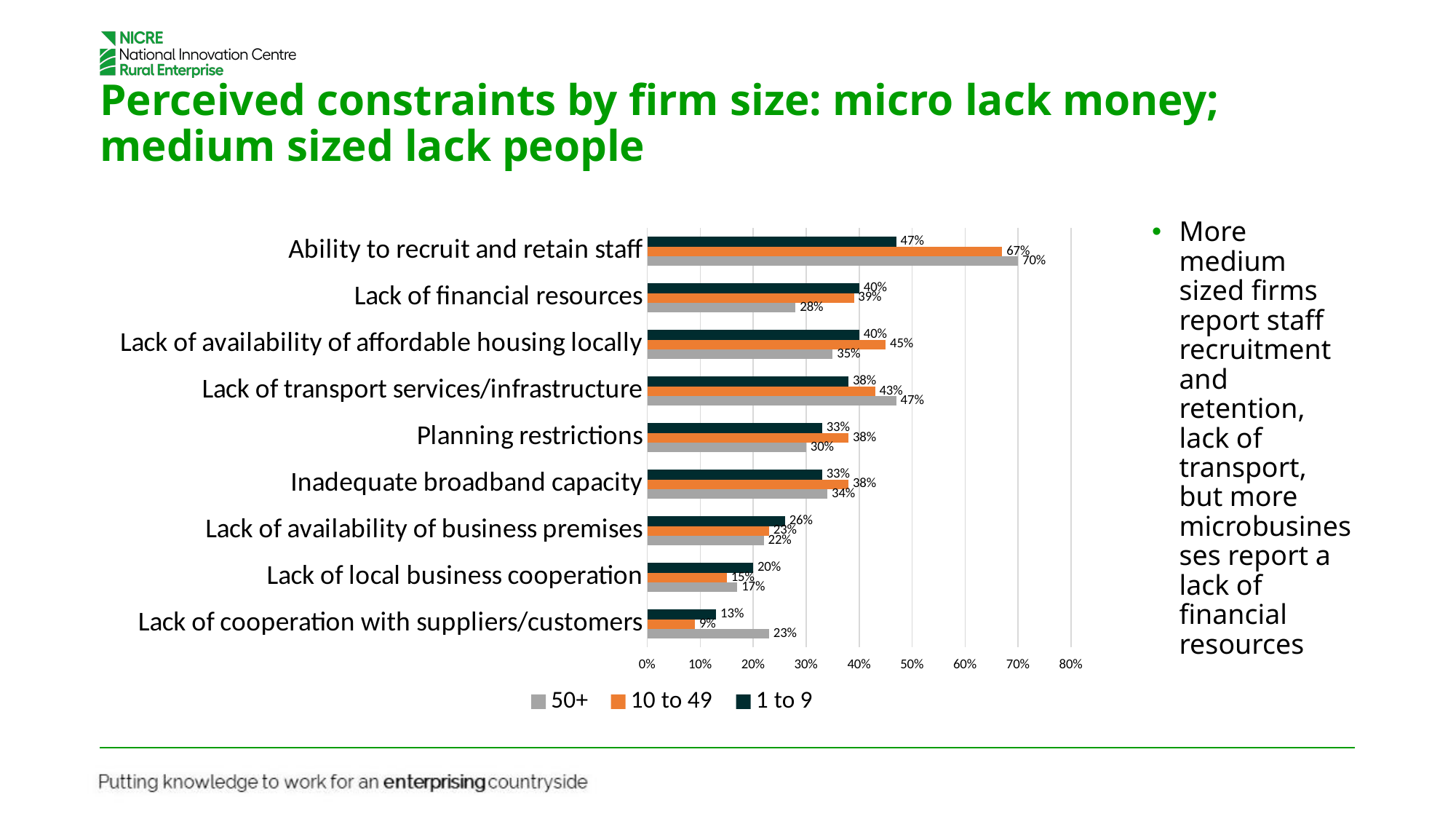
Which constraint has the lowest value for the 1 to 9 series? Lack of cooperation with suppliers/customers What is the difference between the 50+ and 1 to 9 values for 'Ability to recruit and retain staff'? 23 percentage points How many constraint categories are shown on the chart? 9 Is the 50+ value for 'Lack of transport services/infrastructure' greater or less than 40%? greater How many series does the legend list? 3 What is the value for 'Lack of cooperation with suppliers/customers' for the 10 to 49 series? 9% What is the value for 'Lack of financial resources' for the 1 to 9 series? 40% Which colour represents the 10 to 49 series in the legend? Orange What percentage of firms with 50+ employees report 'Ability to recruit and retain staff' as a constraint? 70% Which constraint has the highest value for the 10 to 49 series? Ability to recruit and retain staff For 'Lack of financial resources', which series has the larger value: 1 to 9 or 50+? 1 to 9 What kind of chart is shown on the slide? Bar chart